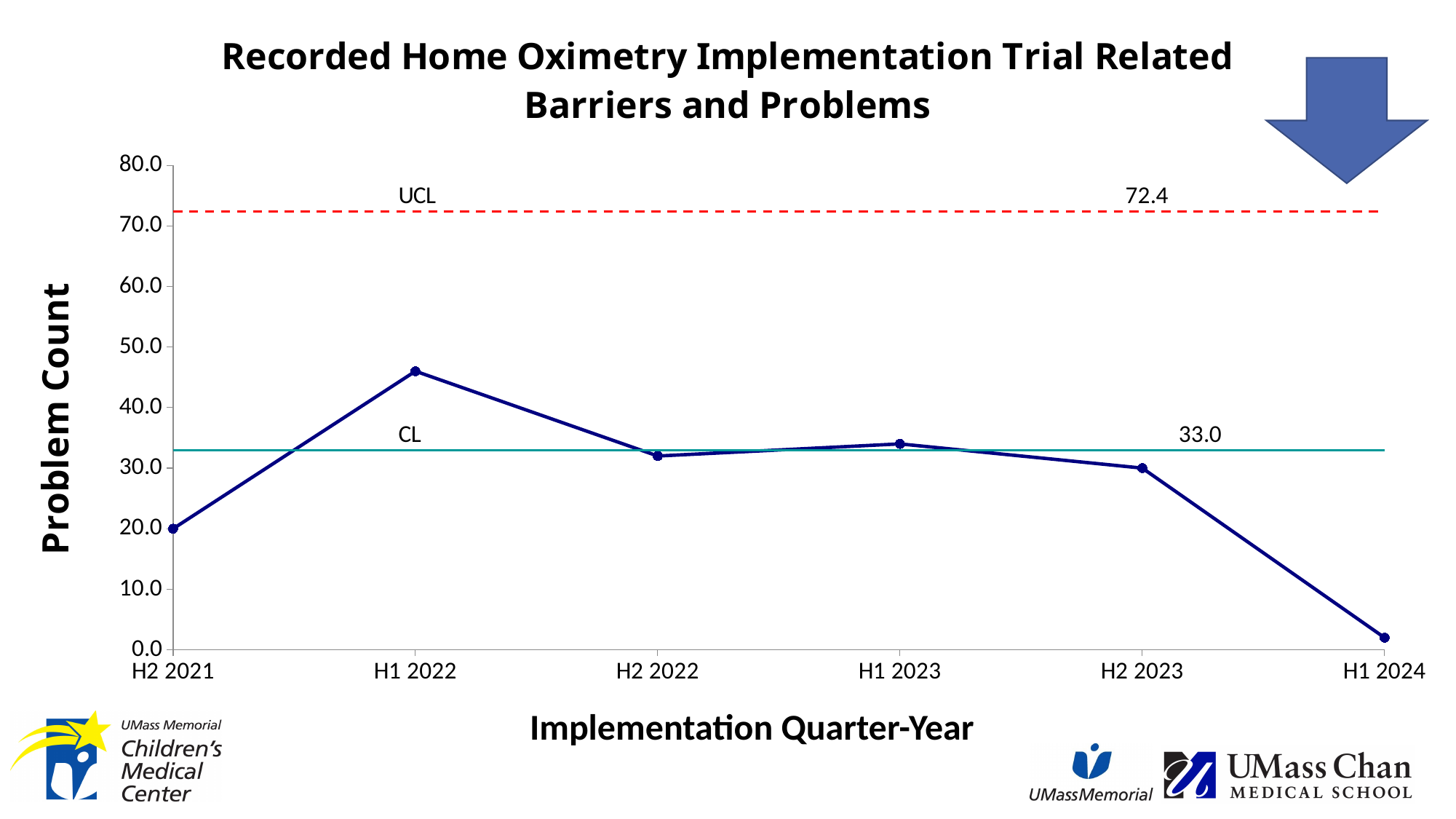
Which period has the lowest problem count? H1 2024 Is the problem count for H2 2021 greater or less than 30? less Does the problem count rise or fall from H2 2023 to H1 2024? fall What is the value of the CL line? 33.0 Which period has the highest problem count? H1 2022 What kind of chart is shown on the slide? line chart What is the value of the UCL line? 72.4 Is the problem count for H1 2022 greater or less than 40? greater Is the problem count for H1 2024 greater or less than 10? less What is the title of the y axis? Problem Count Which period has a higher problem count, H1 2022 or H2 2023? H1 2022 How many data points are plotted on the line for problem count? 6